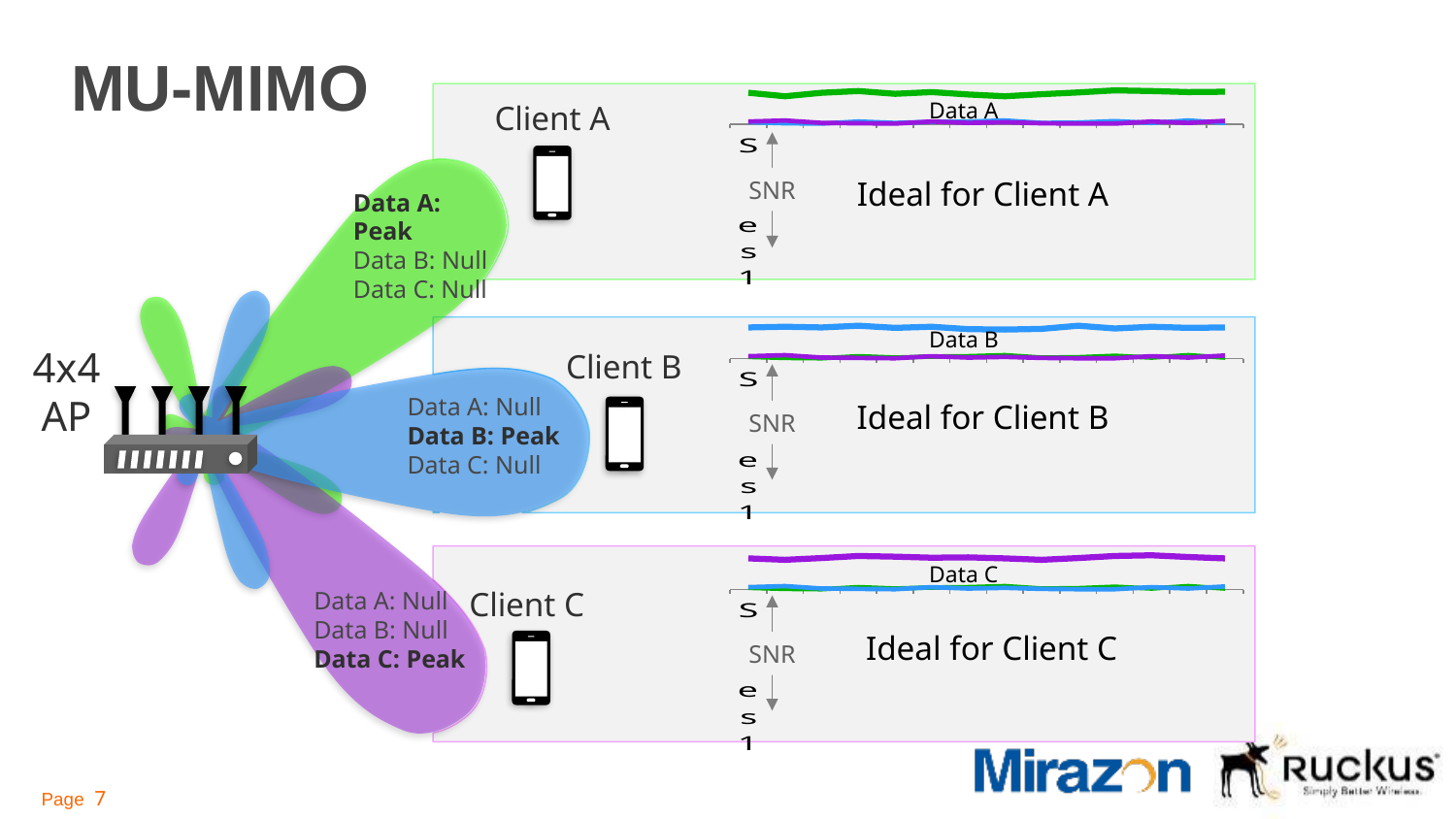
What is the title of the bottom chart on the slide? Data C What label is shown on the vertical axis of the chart titled "Data B"? SNR In the chart titled "Data C", is the green line above or below the purple line? below In the chart titled "Data A", which coloured line is highest? green How many line charts are shown on the slide? 3 In the chart titled "Data B", is the blue line above or below the green line? above In the chart titled "Data A", how many lines are plotted? 3 In the chart titled "Data C", which coloured line is highest? purple In the chart titled "Data A", does the green line rise, fall, or stay roughly flat along the x axis? roughly flat In the chart titled "Data B", which coloured line is highest? blue What kind of chart is the chart titled "Data A"? line chart